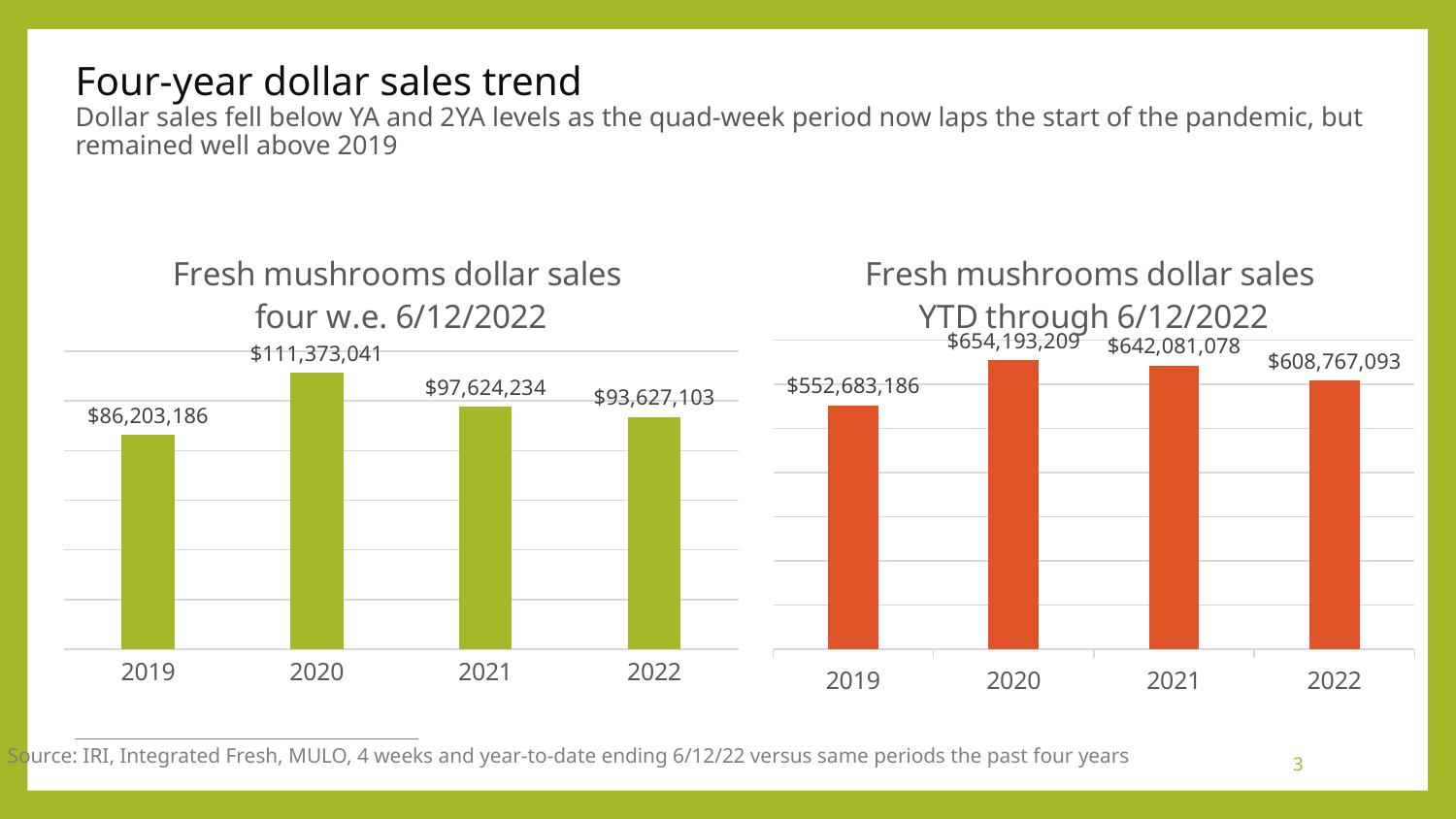
How many years are shown on the x axis of the 'Fresh mushrooms dollar sales YTD through 6/12/2022' chart? 4 In the 'Fresh mushrooms dollar sales YTD through 6/12/2022' chart, what is the value for 2021? $642,081,078 In the 'Fresh mushrooms dollar sales four w.e. 6/12/2022' chart, which year has the highest value? 2020 In the 'Fresh mushrooms dollar sales YTD through 6/12/2022' chart, what is the value for 2019? $552,683,186 In the 'Fresh mushrooms dollar sales four w.e. 6/12/2022' chart, what is the difference between the 2020 and 2019 values? $25,169,855 In the 'Fresh mushrooms dollar sales four w.e. 6/12/2022' chart, what is the value for 2020? $111,373,041 In the 'Fresh mushrooms dollar sales YTD through 6/12/2022' chart, do the values rise or fall from 2020 to 2022? Fall In the 'Fresh mushrooms dollar sales four w.e. 6/12/2022' chart, what is the value for 2022? $93,627,103 In the 'Fresh mushrooms dollar sales four w.e. 6/12/2022' chart, which is larger, the value for 2021 or the value for 2022? 2021 In the 'Fresh mushrooms dollar sales YTD through 6/12/2022' chart, what is the difference between the 2022 and 2019 values? $56,083,907 What type of chart is the 'Fresh mushrooms dollar sales four w.e. 6/12/2022' chart? Bar chart In the 'Fresh mushrooms dollar sales YTD through 6/12/2022' chart, which year has the lowest value? 2019